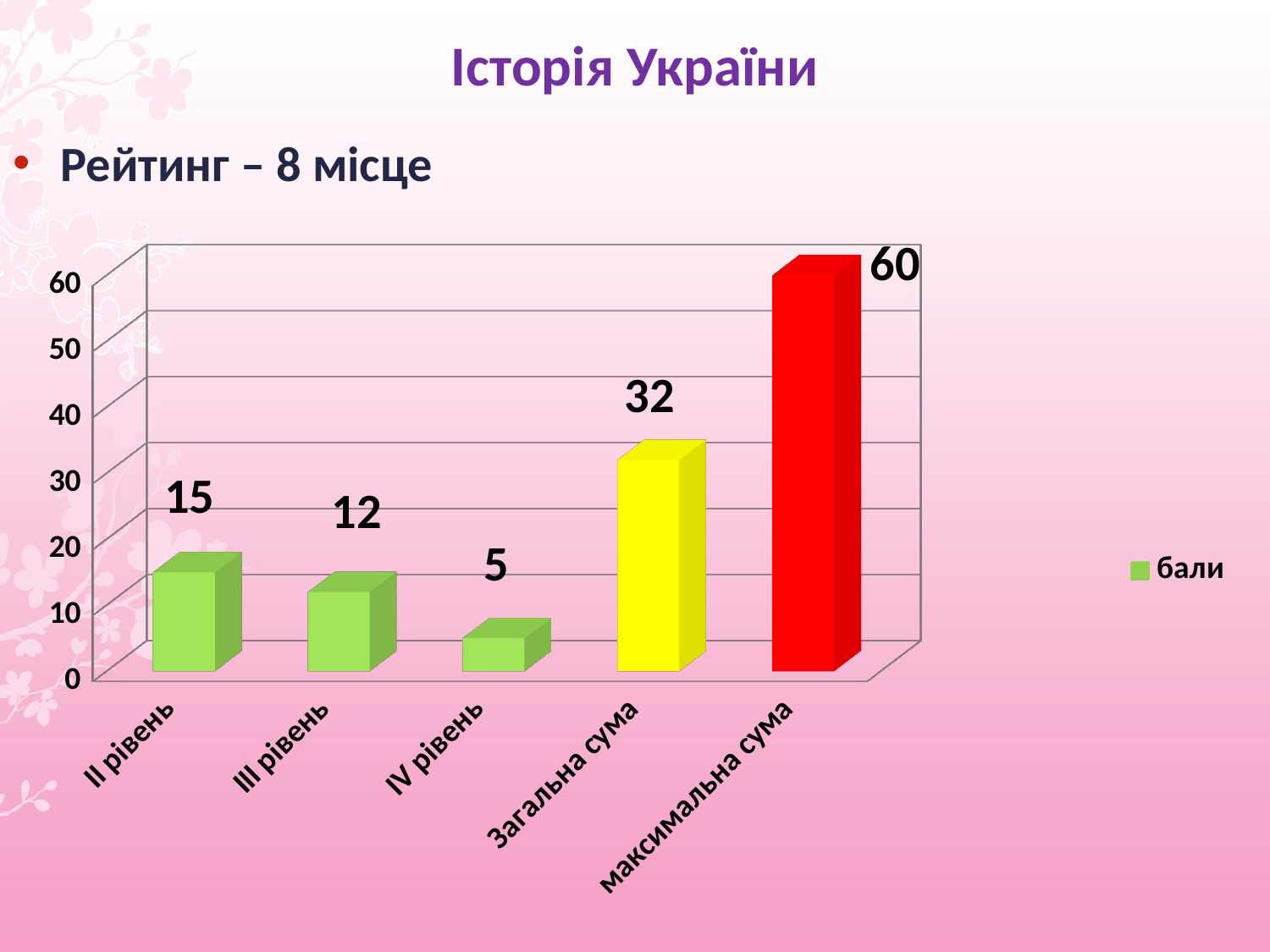
Which is larger, II рівень or III рівень? II рівень What is the value for IV рівень? 5 What is the value for максимальна сума? 60 Which category has the highest value? максимальна сума Which category has the lowest value? IV рівень What is the difference between максимальна сума and Загальна сума? 28 What kind of chart is shown? bar chart What is the value for II рівень? 15 What is the value for III рівень? 12 What series name does the legend list? бали How many categories are shown on the x axis? 5 What is the value for Загальна сума? 32